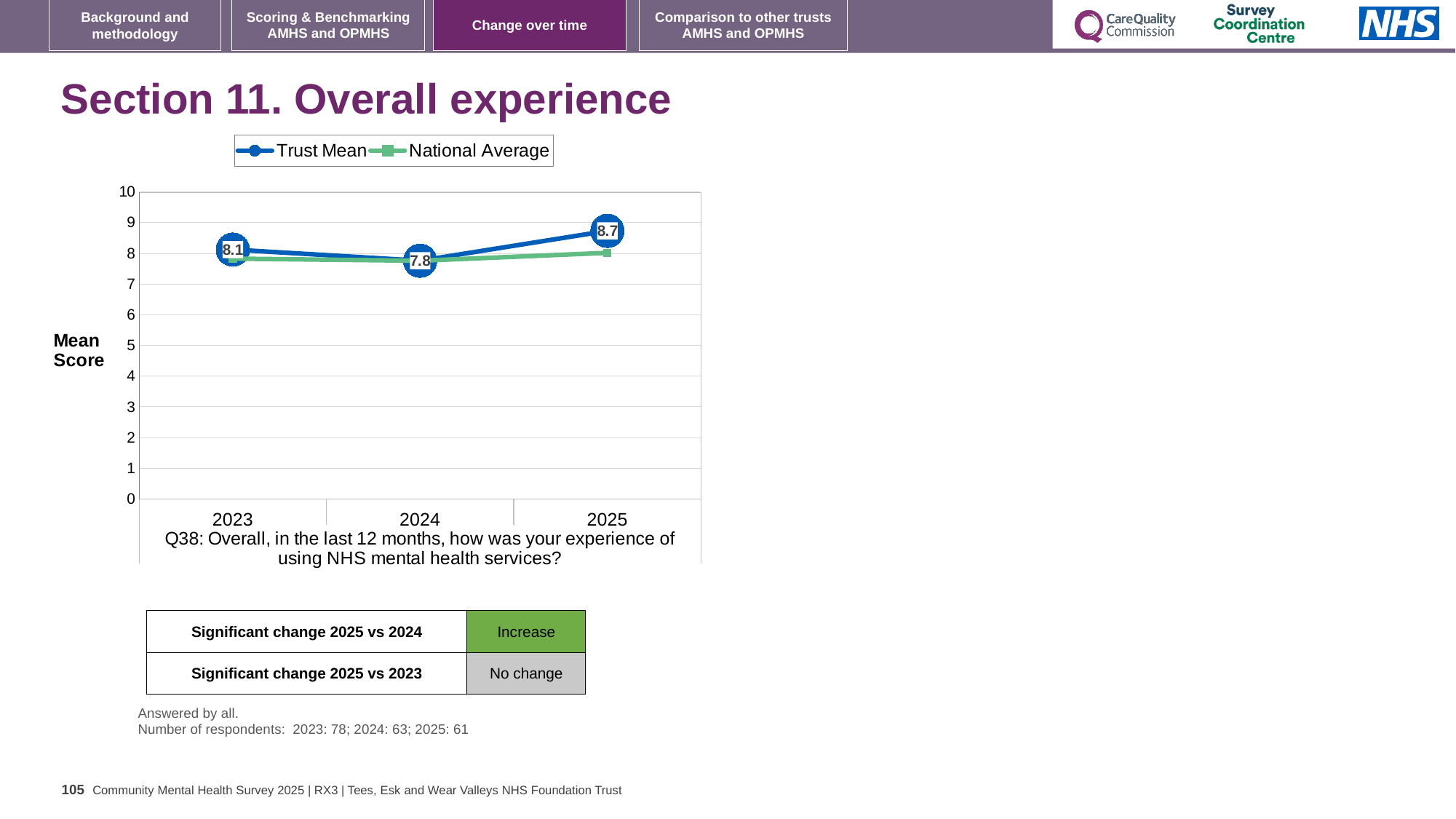
Which is larger, the Trust Mean for 2023 or for 2025? 2025 Does the Trust Mean rise or fall from 2024 to 2025? rise Is the National Average value for 2025 greater or less than 9? less How many series does the legend list? 2 What is the Trust Mean score for 2024? 7.8 What kind of chart is shown? line chart What is the Trust Mean score for 2023? 8.1 How many years are plotted on the x axis? 3 In which year is the Trust Mean highest? 2025 What is the Trust Mean score for 2025? 8.7 In which year is the Trust Mean lowest? 2024 By how much did the Trust Mean change from 2024 to 2025? 0.9